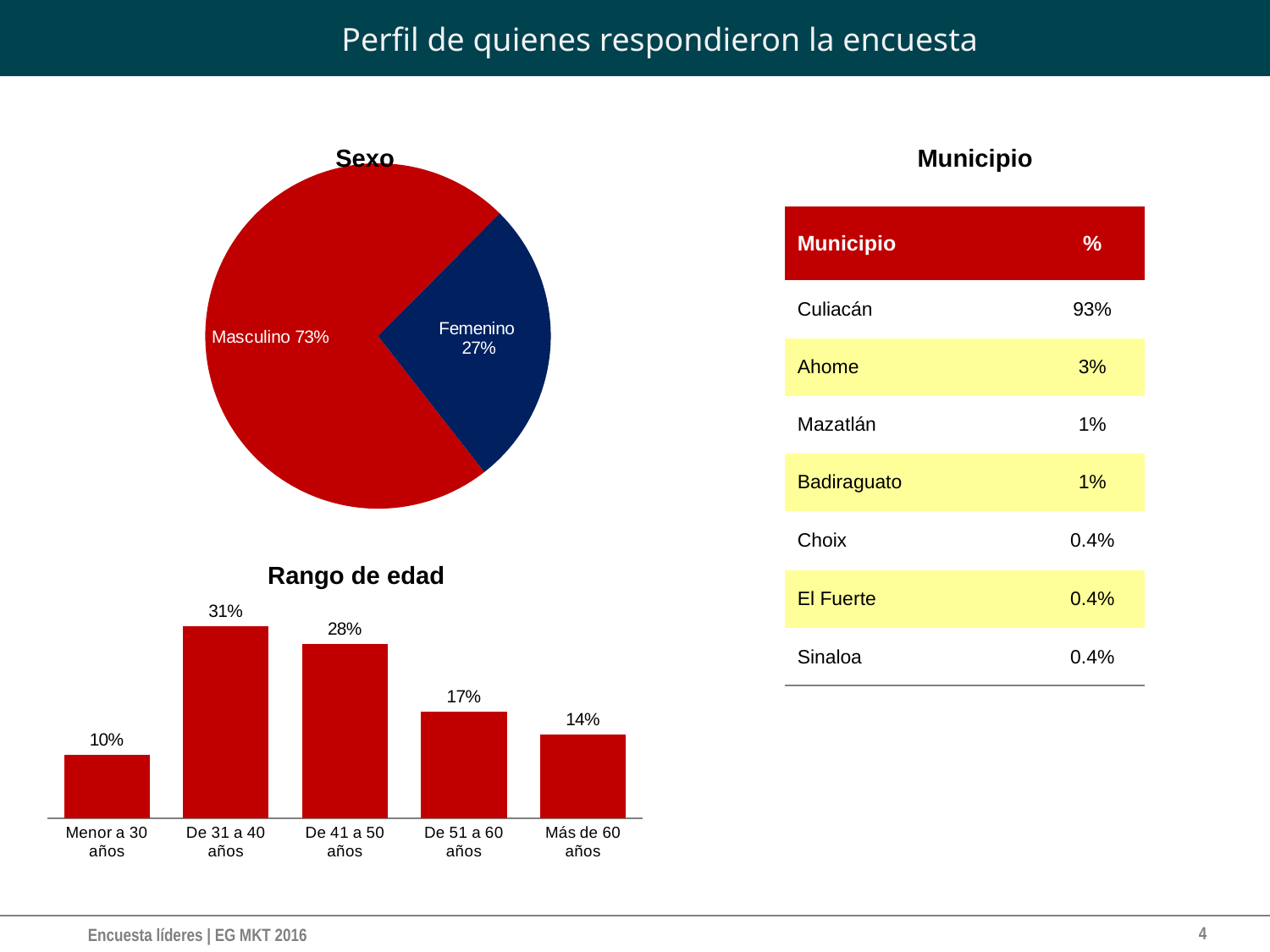
In the 'Rango de edad' chart, how many age ranges are shown? 5 In the 'Rango de edad' chart, what is the difference between 'De 41 a 50 años' and 'De 51 a 60 años'? 11% In the 'Sexo' chart, what share of respondents are Femenino? 27% In the 'Rango de edad' chart, what is the value for 'Más de 60 años'? 14% What kind of chart is the 'Sexo' chart? Pie chart In the 'Sexo' chart, how many slices are there? 2 What kind of chart is the 'Rango de edad' chart? Bar chart In the 'Sexo' chart, what share of respondents are Masculino? 73% In the 'Rango de edad' chart, which age range has the lowest value? Menor a 30 años In the 'Rango de edad' chart, which is larger: 'Menor a 30 años' or 'De 51 a 60 años'? De 51 a 60 años In the 'Rango de edad' chart, what is the value for 'De 31 a 40 años'? 31% In the 'Rango de edad' chart, which age range has the highest value? De 31 a 40 años